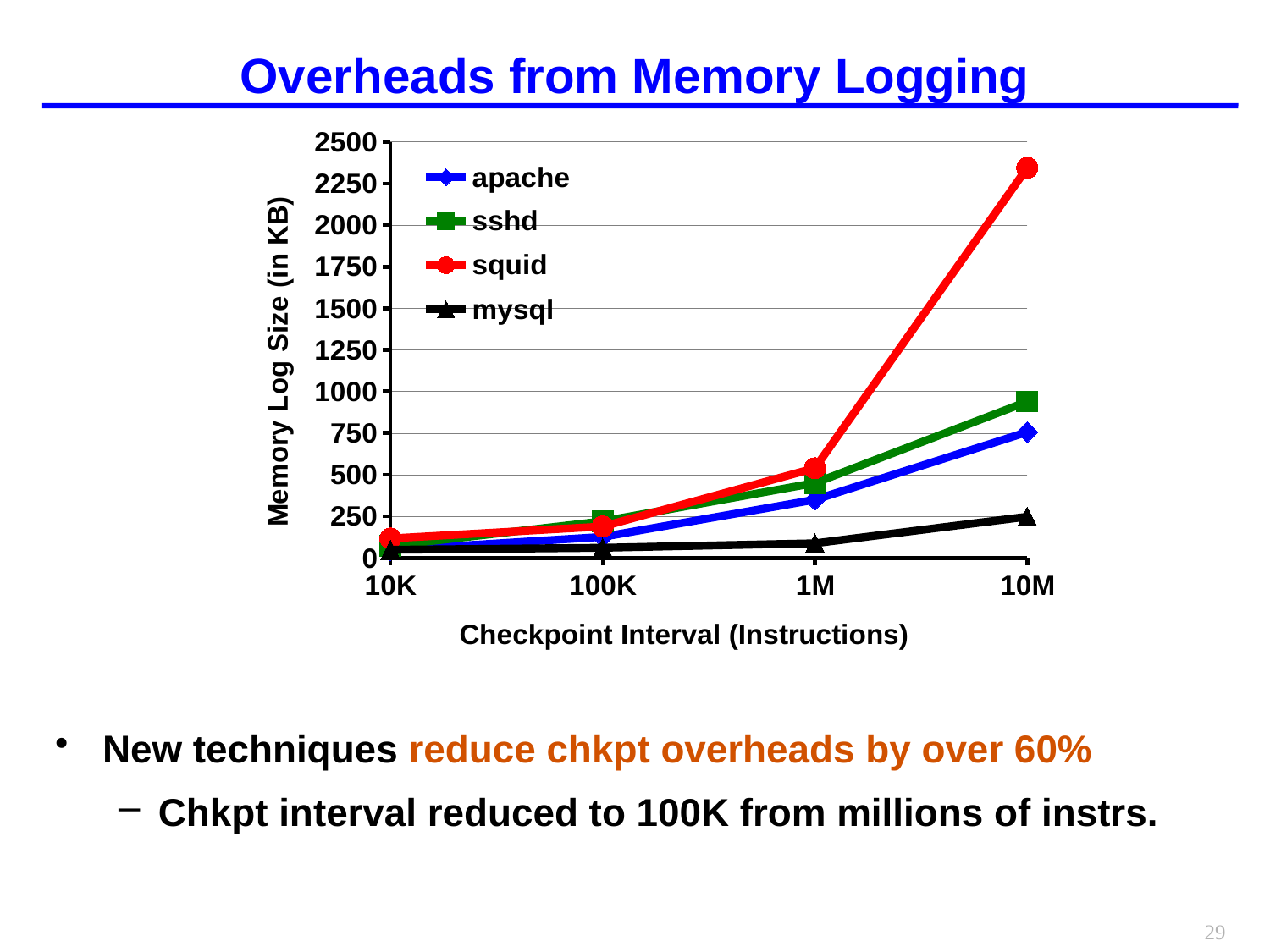
Is the memory log size for mysql at 10M greater or less than 500? less Is the memory log size for squid at 1M greater or less than 250? greater Which series has the lowest memory log size at the 10M checkpoint interval? mysql Is the memory log size for apache at 10M greater or less than 1000? less Does the memory log size for squid rise or fall as the checkpoint interval increases from 10K to 10M? rise What kind of chart is shown on the slide? line chart How many series does the legend list? 4 How many checkpoint interval values are shown on the x axis? 4 At the 10M checkpoint interval, which has the larger memory log size, sshd or apache? sshd Which series has the highest memory log size at the 10M checkpoint interval? squid What is the label of the y axis? Memory Log Size (in KB)